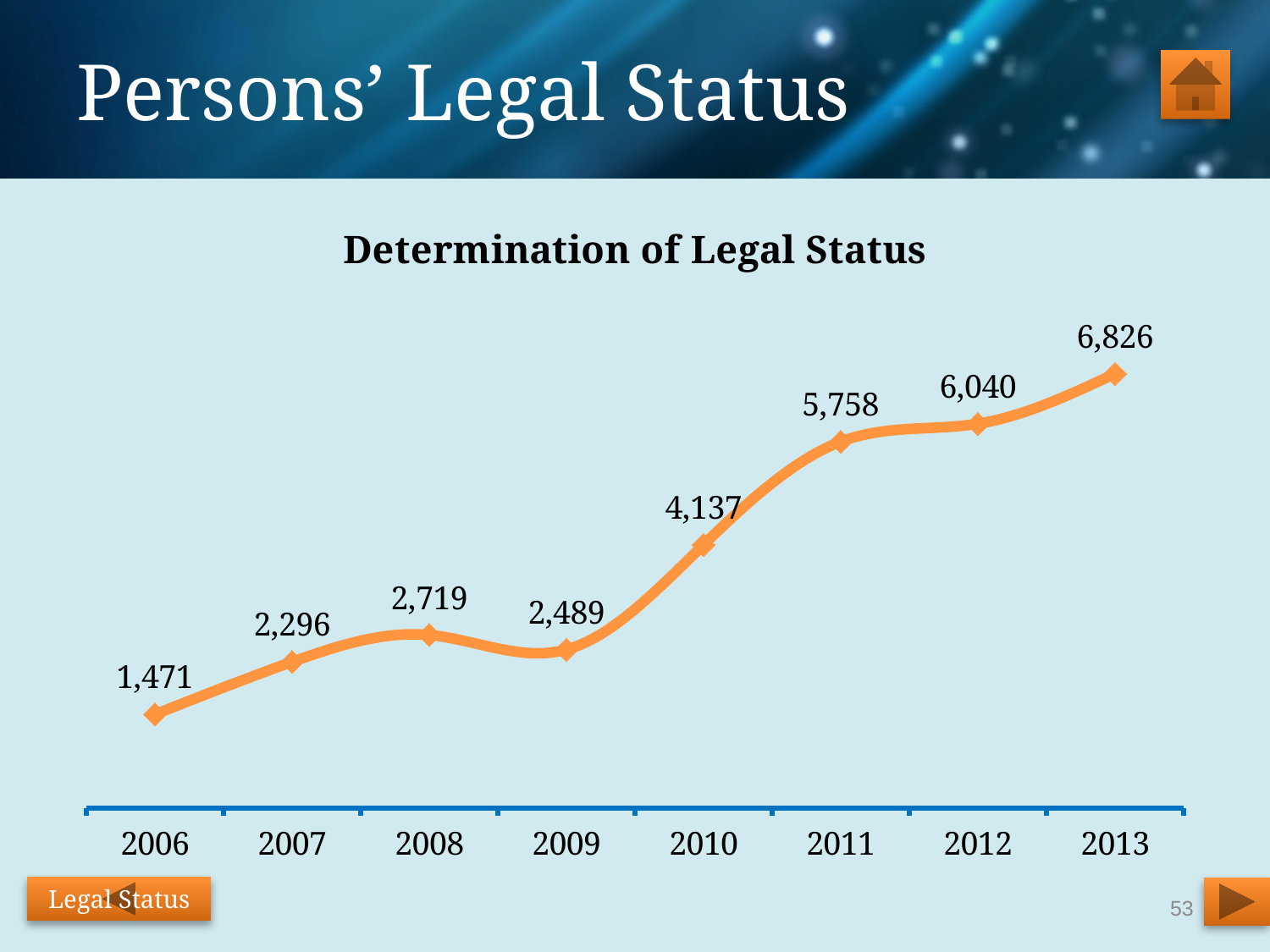
How many years are plotted on the chart? 8 Do the values generally rise or fall from 2006 to 2013? rise What is the title of the chart? Determination of Legal Status Which year has the highest value? 2013 What is the value for 2013? 6,826 Which year has the lowest value? 2006 Which is larger, the value for 2008 or the value for 2009? 2008 What is the value for 2010? 4,137 What is the difference between the values for 2011 and 2010? 1,621 What is the value for 2006? 1,471 What kind of chart is this? line chart What is the difference between the values for 2013 and 2012? 786